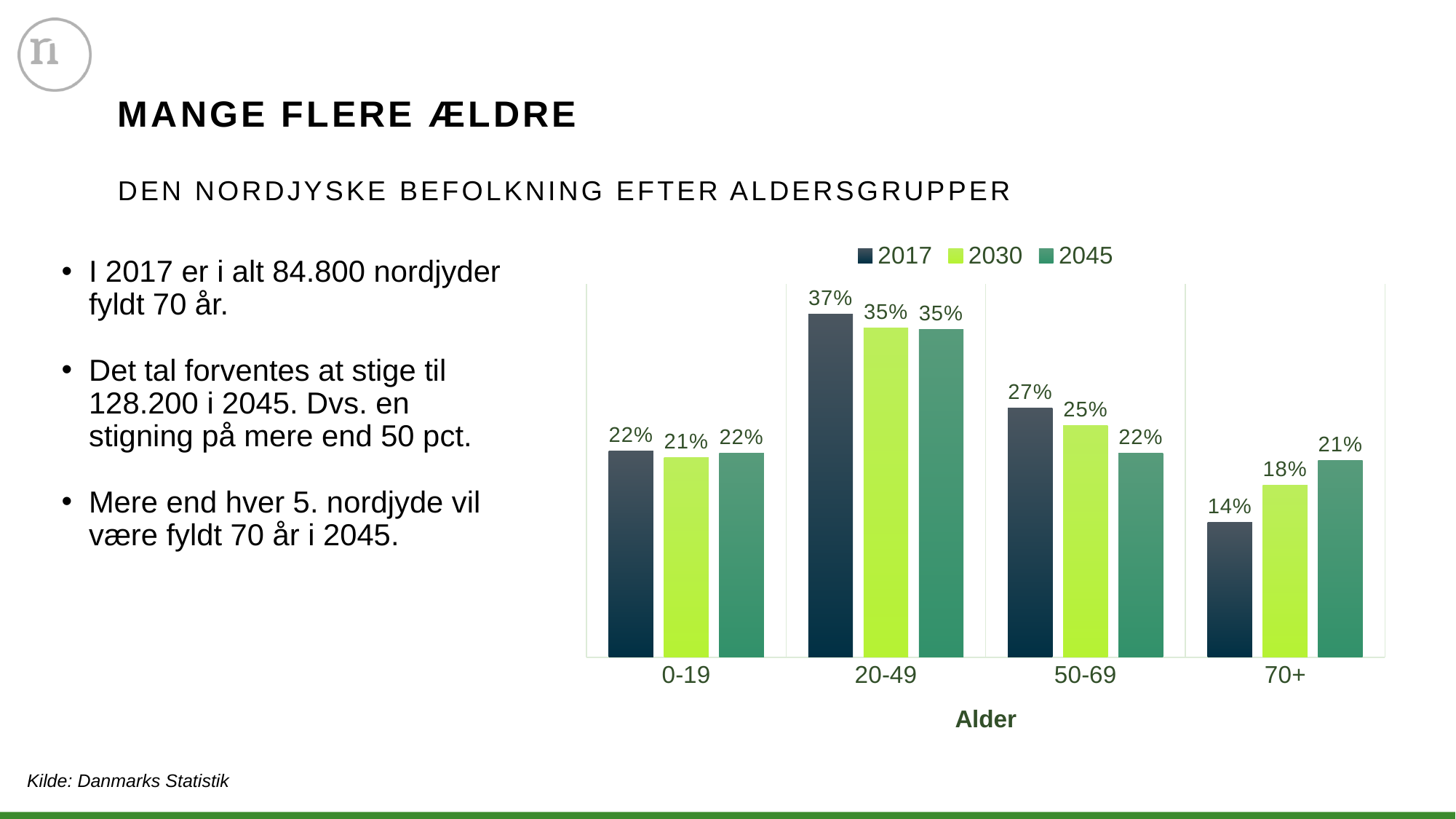
What is the value for the 20-49 age group in 2045? 35% How many age groups are shown on the x axis? 4 What is the difference between the 2017 and 2045 values for the 70+ age group? 7 percentage points What is the difference between the 2017 and 2045 values for the 50-69 age group? 5 percentage points Which age group has the highest value in 2017? 20-49 What is the value for the 70+ age group in 2017? 14% What kind of chart is shown on the slide? Bar chart For the 50-69 age group, which is larger: the 2017 value or the 2030 value? 2017 How many series does the legend list? 3 Which age group has the lowest value in 2030? 70+ What is the label of the x axis? Alder What is the value for the 50-69 age group in 2030? 25%